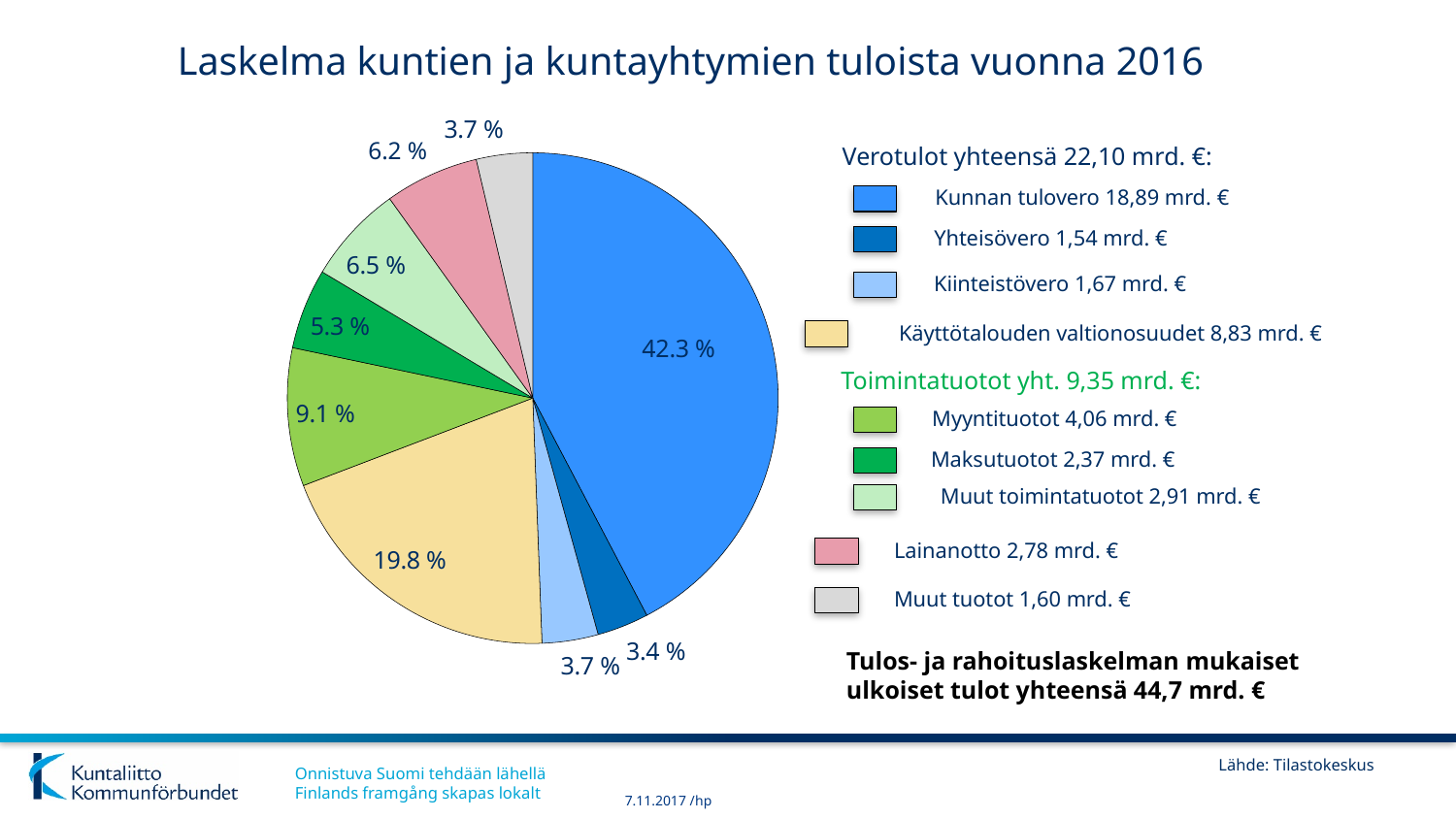
What is the difference in percentage points between the Käyttötalouden valtionosuudet share and the Myyntituotot share? 10.7 % What percentage share of the pie does Kunnan tulovero have? 42.3 % What is the title of the chart? Laskelma kuntien ja kuntayhtymien tuloista vuonna 2016 Which slice of the pie is the largest? Kunnan tulovero What value does the legend give for Kiinteistövero? 1,67 mrd. € Which is larger, the share for Maksutuotot or the share for Muut toimintatuotot? Muut toimintatuotot Which slice of the pie is the smallest? Yhteisövero What percentage share of the pie does Lainanotto have? 6.2 % What kind of chart is shown on the slide? pie chart What percentage share of the pie does Myyntituotot have? 9.1 % How many slices does the pie chart have? 9